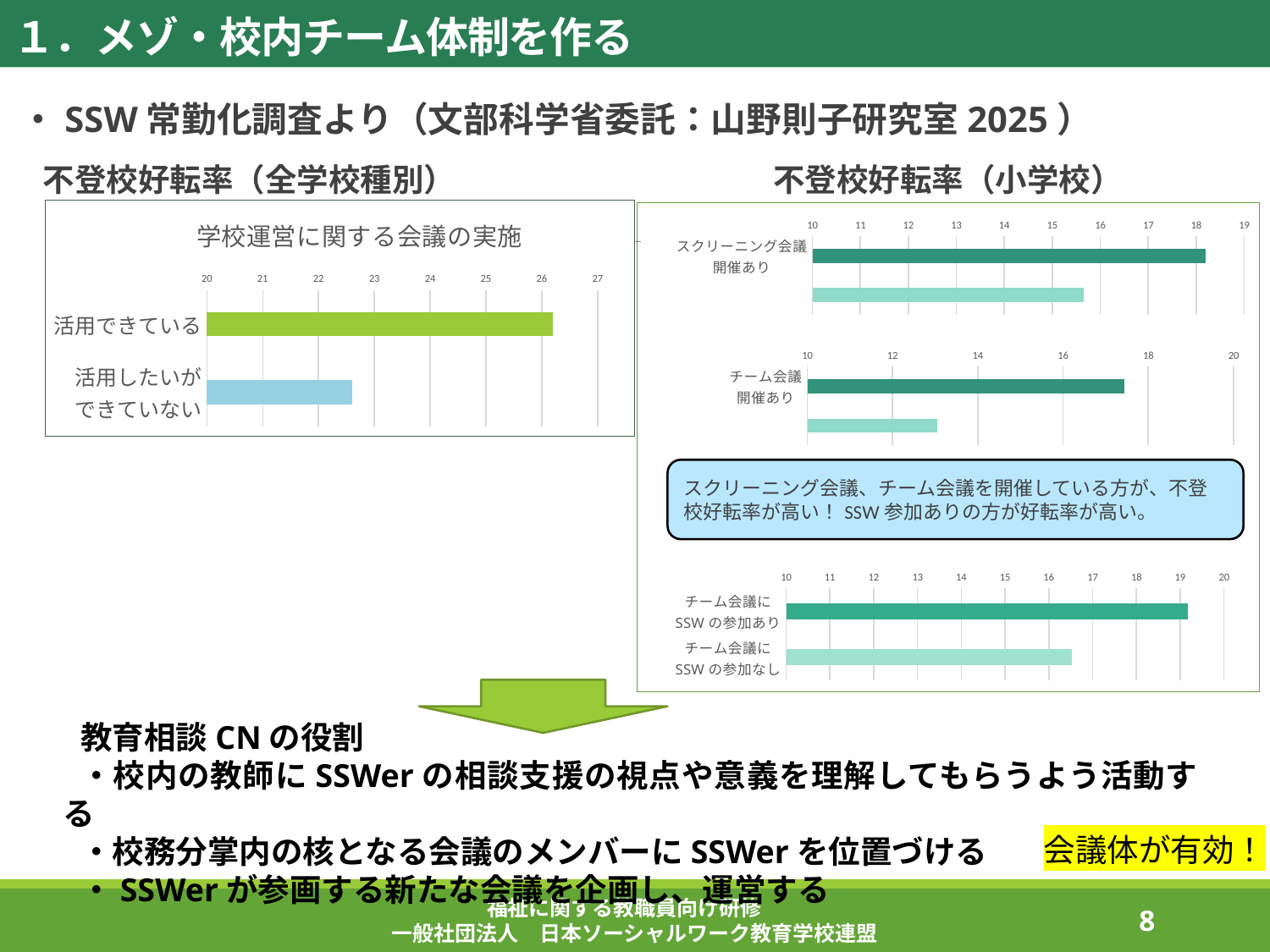
In the bottom-right chart (チーム会議にSSWの参加あり / なし), which category has the longer bar? チーム会議にSSWの参加あり What kind of chart is the chart titled 学校運営に関する会議の実施? bar chart In the chart titled 学校運営に関する会議の実施, is the value for 活用できている greater or less than 25? greater In the chart titled 学校運営に関する会議の実施, is the value for 活用したいができていない greater or less than 24? less In the bottom-right chart, is the value for チーム会議にSSWの参加あり greater or less than 18? greater In the chart titled 学校運営に関する会議の実施, which category has the longer bar, 活用できている or 活用したいができていない? 活用できている In the chart titled 学校運営に関する会議の実施, what colour is the bar for 活用できている? green In the bottom-right chart, how many categories are plotted? 2 In the chart titled 学校運営に関する会議の実施, how many categories are plotted? 2